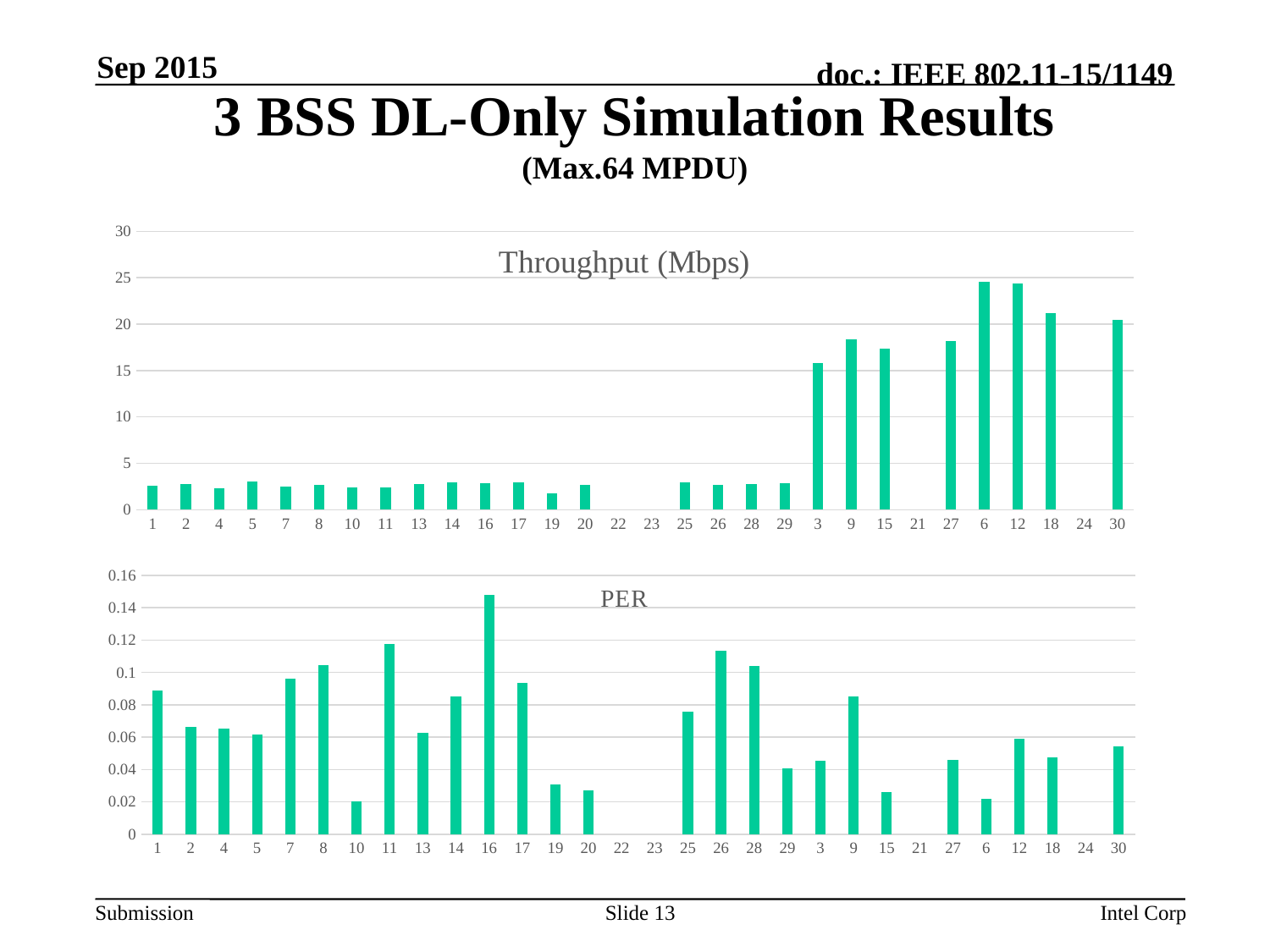
In the Throughput (Mbps) chart, is the value for category 6 greater or less than 20? greater What kind of chart is the Throughput (Mbps) chart? bar chart In the Throughput (Mbps) chart, is the value for category 9 greater or less than 15? greater In the PER chart, is the value for category 11 greater or less than 0.1? greater In the PER chart, which is larger, the value for category 16 or category 11? 16 What is the title of the top chart on the slide? Throughput (Mbps) In the Throughput (Mbps) chart, which is larger, the value for category 3 or category 9? 9 What kind of chart is the PER chart? bar chart In the PER chart, which category has the highest value? 16 How many categories are shown on the x axis of the PER chart? 30